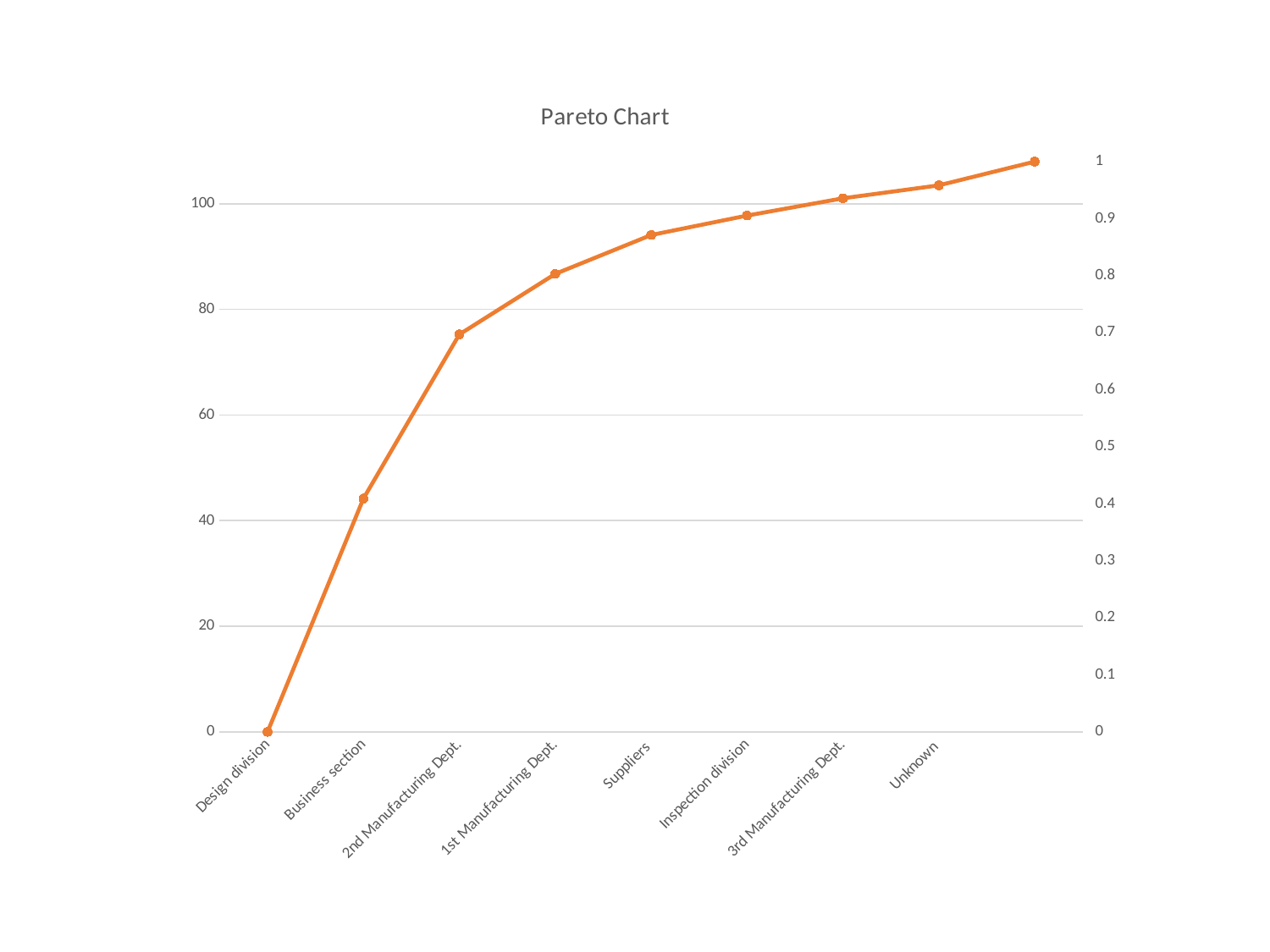
Which has the larger value, Business section or 2nd Manufacturing Dept.? 2nd Manufacturing Dept. Is the value for 2nd Manufacturing Dept. greater or less than 0.6 on the right-hand axis? greater Which category has the lowest value? Design division What colour is the plotted line? orange Is the value for Suppliers greater or less than 0.8 on the right-hand axis? greater What is the title of the chart? Pareto Chart Is the value for Unknown greater or less than 0.9 on the right-hand axis? greater What is the value for Design division? 0 How many category labels are shown along the x axis? 8 Do the plotted values rise or fall from left to right along the x axis? rise What kind of chart is shown on the slide? line chart